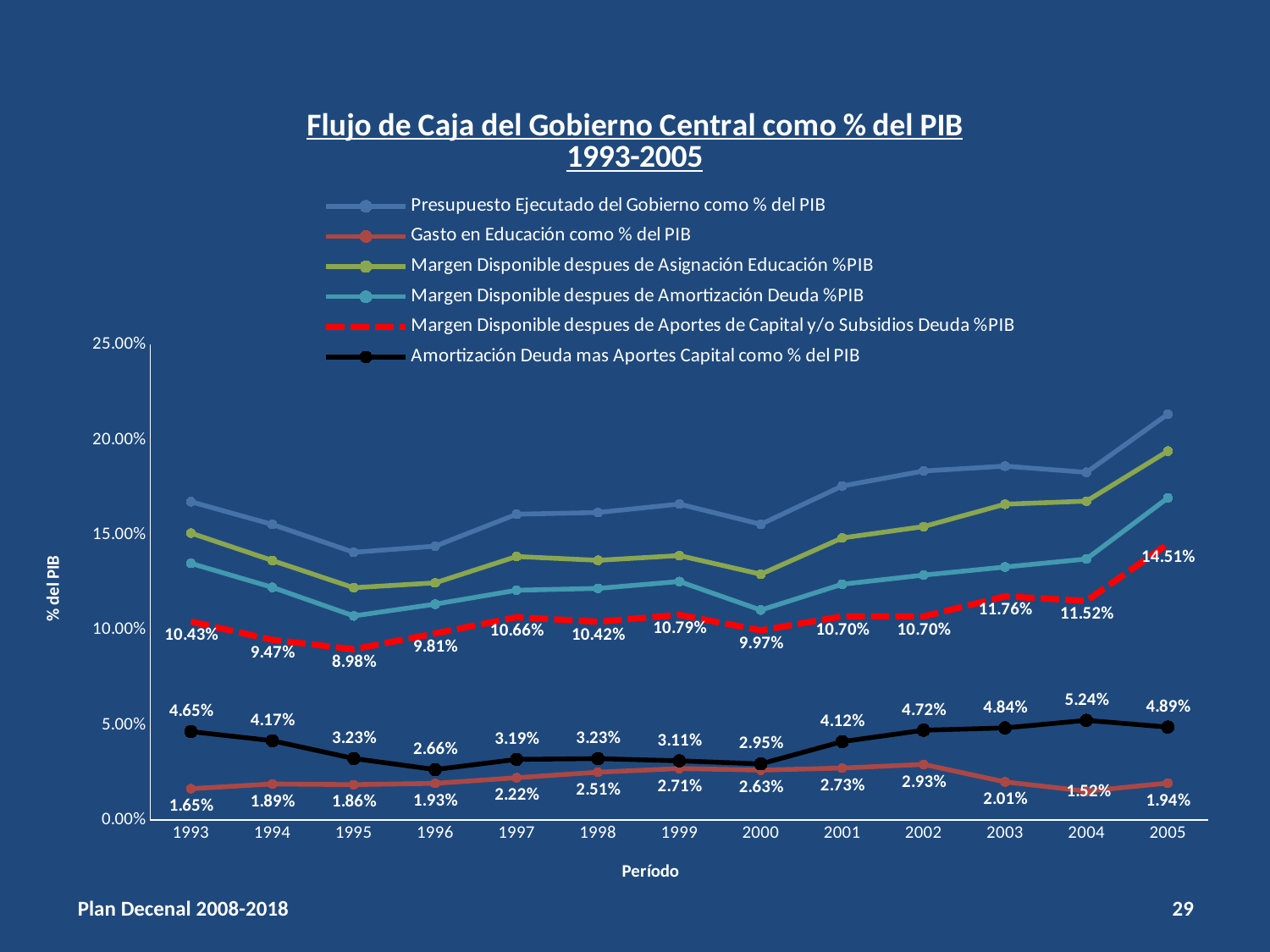
How many series does the legend list? 6 Is the value of Presupuesto Ejecutado del Gobierno como % del PIB in 2005 greater or less than 20.00%? greater What is the title of the chart? Flujo de Caja del Gobierno Central como % del PIB 1993-2005 What is the value of Gasto en Educación como % del PIB in 2002? 2.93% In which year is Margen Disponible despues de Aportes de Capital y/o Subsidios Deuda %PIB lowest? 1995 What is the value of Amortización Deuda mas Aportes Capital como % del PIB in 1996? 2.66% Which is larger in 2003: Gasto en Educación como % del PIB or Amortización Deuda mas Aportes Capital como % del PIB? Amortización Deuda mas Aportes Capital como % del PIB What is the difference between Amortización Deuda mas Aportes Capital como % del PIB in 1993 and in 1994? 0.48% What kind of chart is shown on the slide? line chart How many years are shown on the x axis? 13 In which year is Amortización Deuda mas Aportes Capital como % del PIB highest? 2004 What is the value of Margen Disponible despues de Aportes de Capital y/o Subsidios Deuda %PIB in 2005? 14.51%